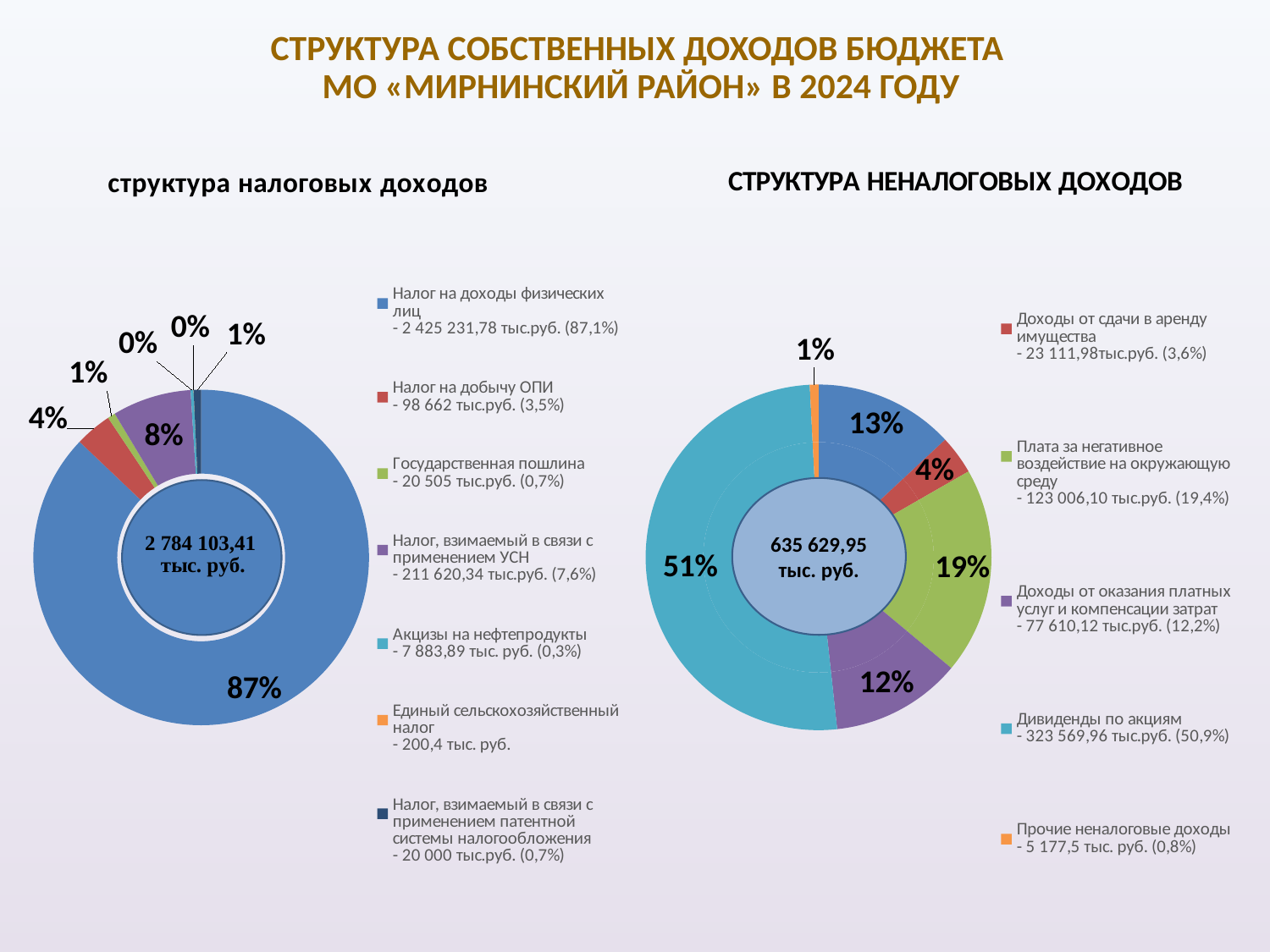
On the chart titled «СТРУКТУРА НЕНАЛОГОВЫХ ДОХОДОВ», which category has the smallest share? Прочие неналоговые доходы On the chart titled «структура налоговых доходов», how many entries does the legend list? 7 On the chart titled «структура налоговых доходов», what share is shown for Налог на добычу ОПИ? 4% On the chart titled «структура налоговых доходов», which category has the largest share? Налог на доходы физических лиц On the chart titled «структура налоговых доходов», what share is shown for Налог на доходы физических лиц? 87% On the chart titled «СТРУКТУРА НЕНАЛОГОВЫХ ДОХОДОВ», which is larger: the share for Доходы от сдачи в аренду имущества or the share for Доходы от оказания платных услуг и компенсации затрат? Доходы от оказания платных услуг и компенсации затрат On the chart titled «структура налоговых доходов», what total value is printed in the centre of the doughnut? 2 784 103,41 тыс. руб. On the chart titled «СТРУКТУРА НЕНАЛОГОВЫХ ДОХОДОВ», what share is shown for Доходы от оказания платных услуг и компенсации затрат? 12% What kind of chart is used on the right side of the slide, titled «СТРУКТУРА НЕНАЛОГОВЫХ ДОХОДОВ»? Doughnut chart On the chart titled «СТРУКТУРА НЕНАЛОГОВЫХ ДОХОДОВ», what share is shown for Дивиденды по акциям? 51% On the chart titled «структура налоговых доходов», what share is shown for Налог, взимаемый в связи с применением УСН? 8% On the chart titled «СТРУКТУРА НЕНАЛОГОВЫХ ДОХОДОВ», what share is shown for Плата за негативное воздействие на окружающую среду? 19%